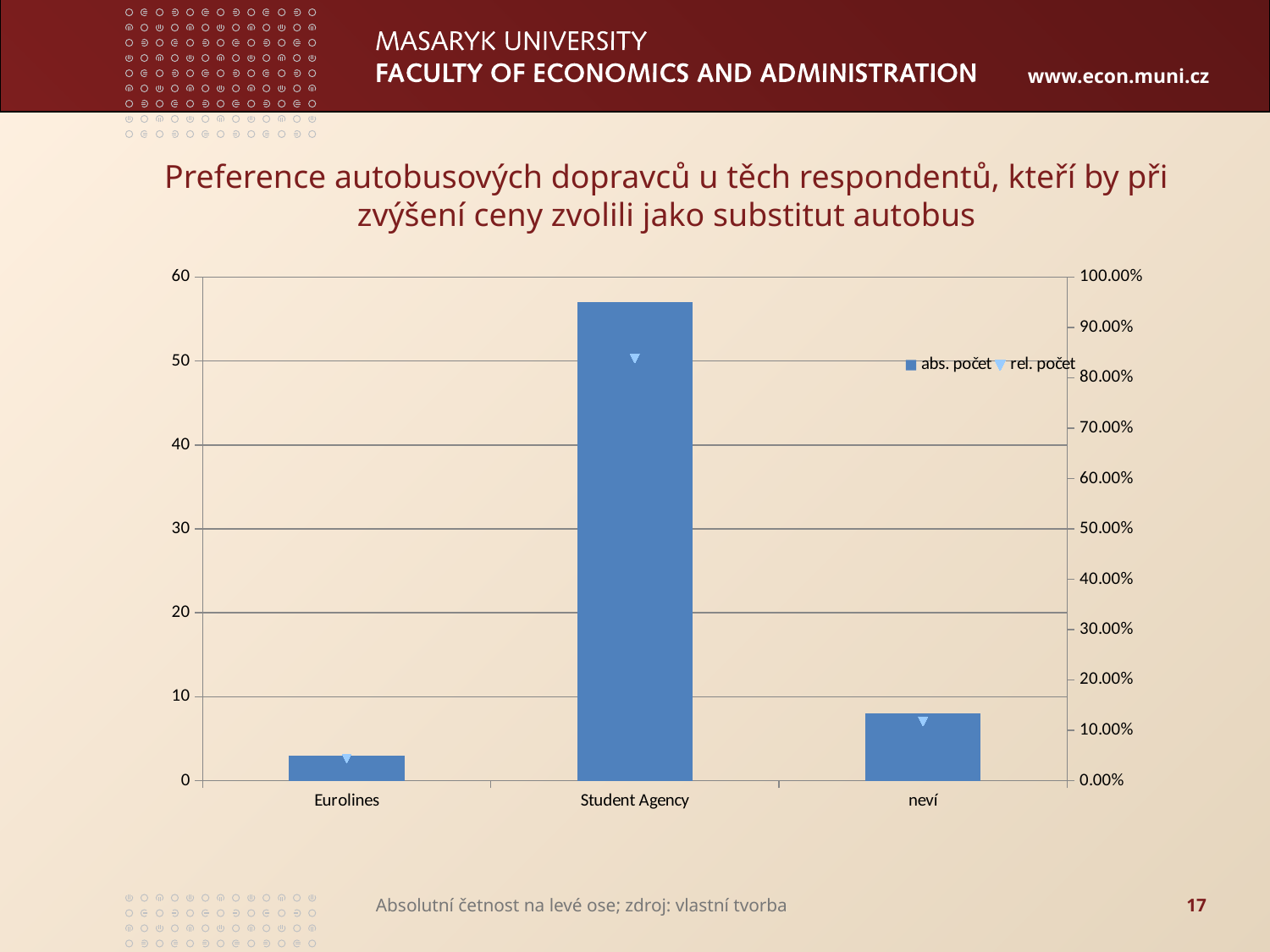
Which has a larger abs. počet value, neví or Eurolines? neví Which category has the highest abs. počet value? Student Agency Is the abs. počet value for neví greater or less than 10? less Is the rel. počet value for Student Agency greater or less than 70.00%? greater How many categories are shown on the x axis of the chart? 3 Is the abs. počet value for Eurolines greater or less than 10? less What are the two series named in the chart legend? abs. počet and rel. počet What kind of chart is shown on the slide? bar chart Which category has the lowest abs. počet value? Eurolines How many series does the chart legend list? 2